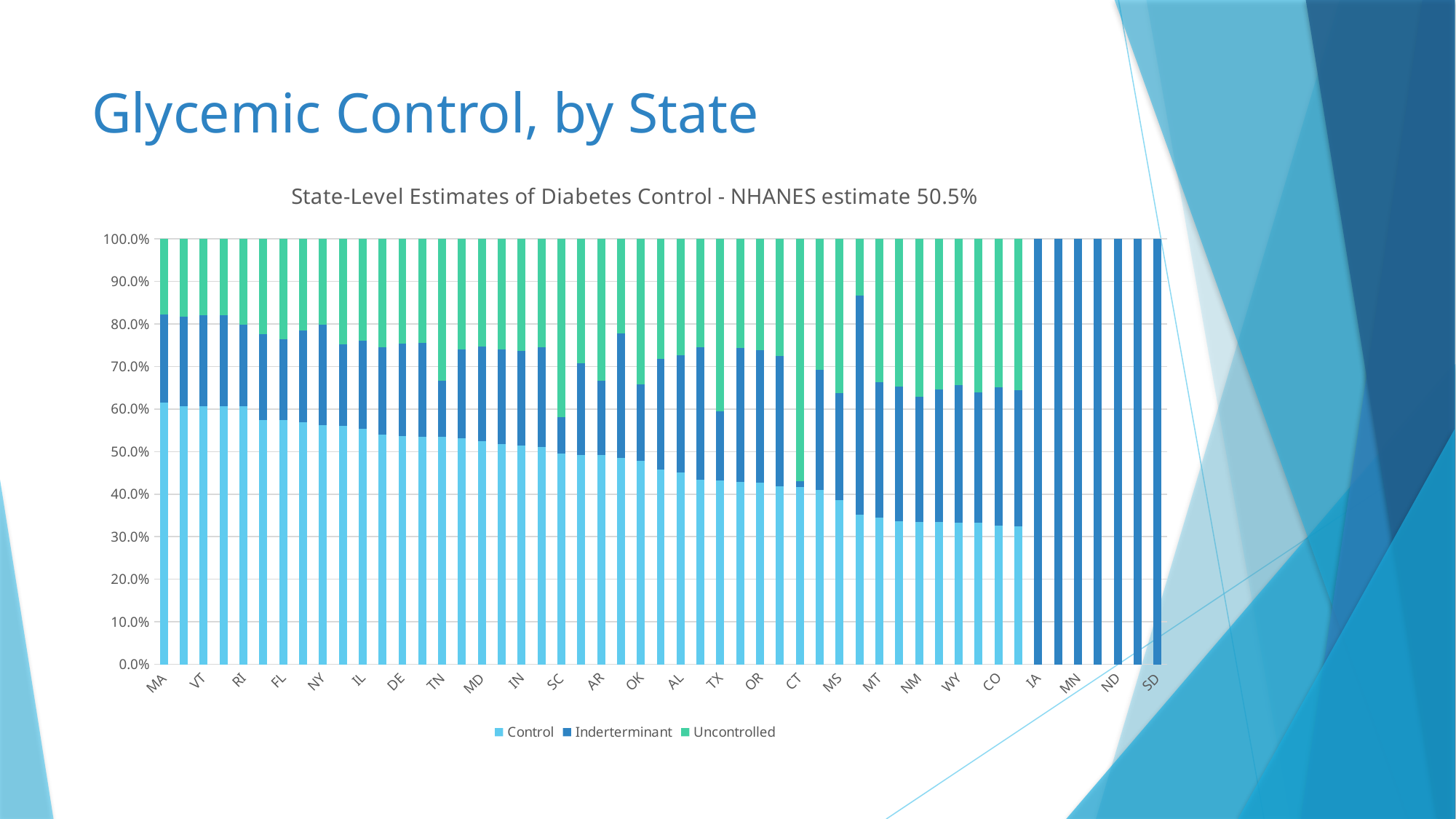
How many series does the legend list? 3 Is the Control value for TN greater or less than 60.0%? less Is the Control value for MA greater or less than 50.0%? greater Which state has the larger Control share, TN or MS? TN Do the Control values generally rise or fall moving from left to right along the x axis? Fall Is the Control value for CO greater or less than 40.0%? less What NHANES estimate is quoted in the chart title? 50.5% What kind of chart is shown on the slide? Stacked bar chart Which state has the larger Control share, MA or CO? MA What are the three series named in the legend? Control, Inderterminant, Uncontrolled